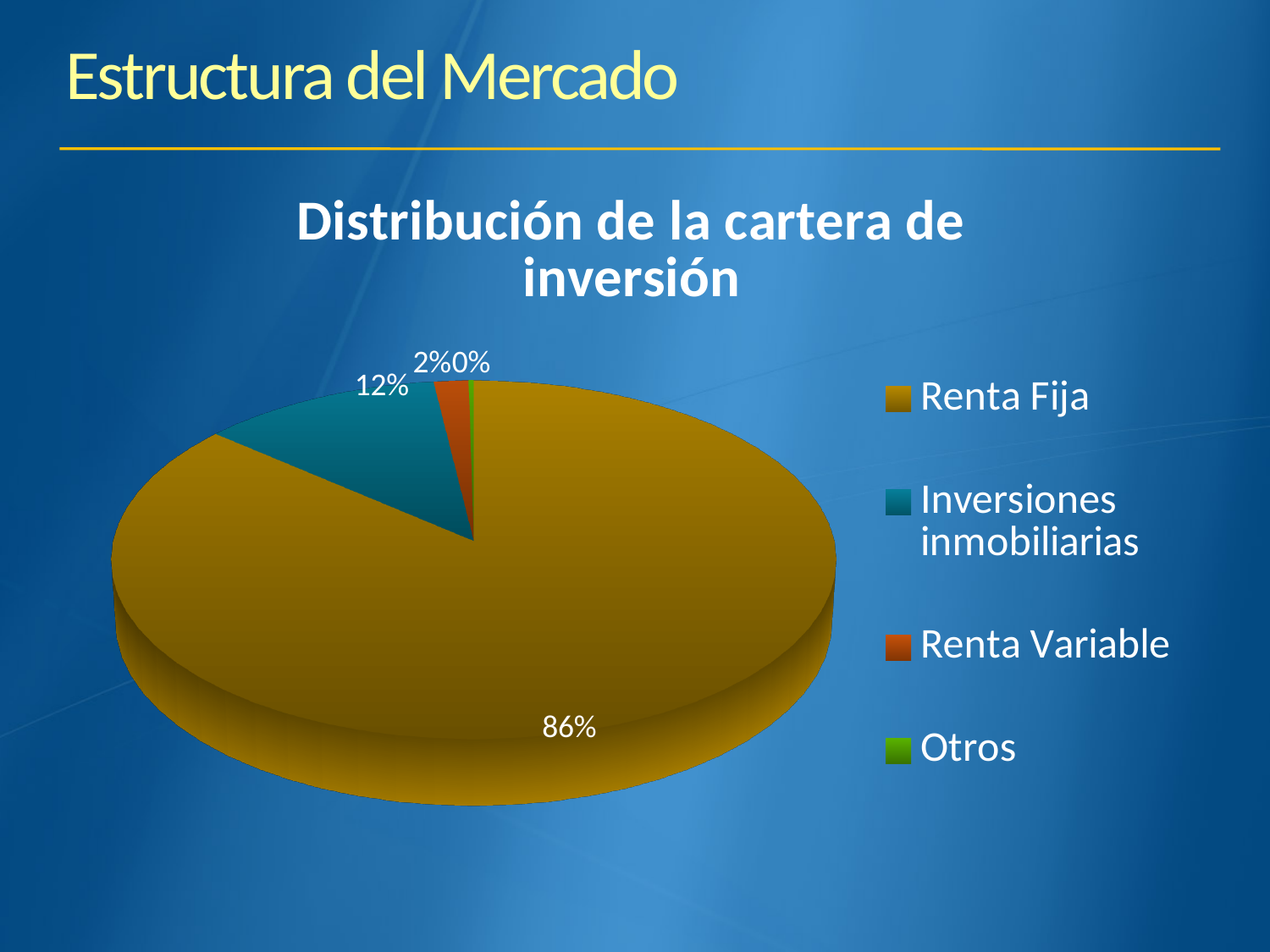
Which category has the largest share of the pie? Renta Fija What kind of chart is shown on the slide? Pie chart Which is larger, the share for Inversiones inmobiliarias or the share for Renta Variable? Inversiones inmobiliarias What colour is the Renta Fija slice? Gold What share of the pie does Renta Variable represent? 2% Which category has the smallest share of the pie? Otros How many categories does the legend list? 4 What share of the pie does Inversiones inmobiliarias represent? 12% What share of the pie does Otros represent? 0% What is the difference in percentage points between Renta Fija and Inversiones inmobiliarias? 74 What is the title of the chart? Distribución de la cartera de inversión What share of the pie does Renta Fija represent? 86%